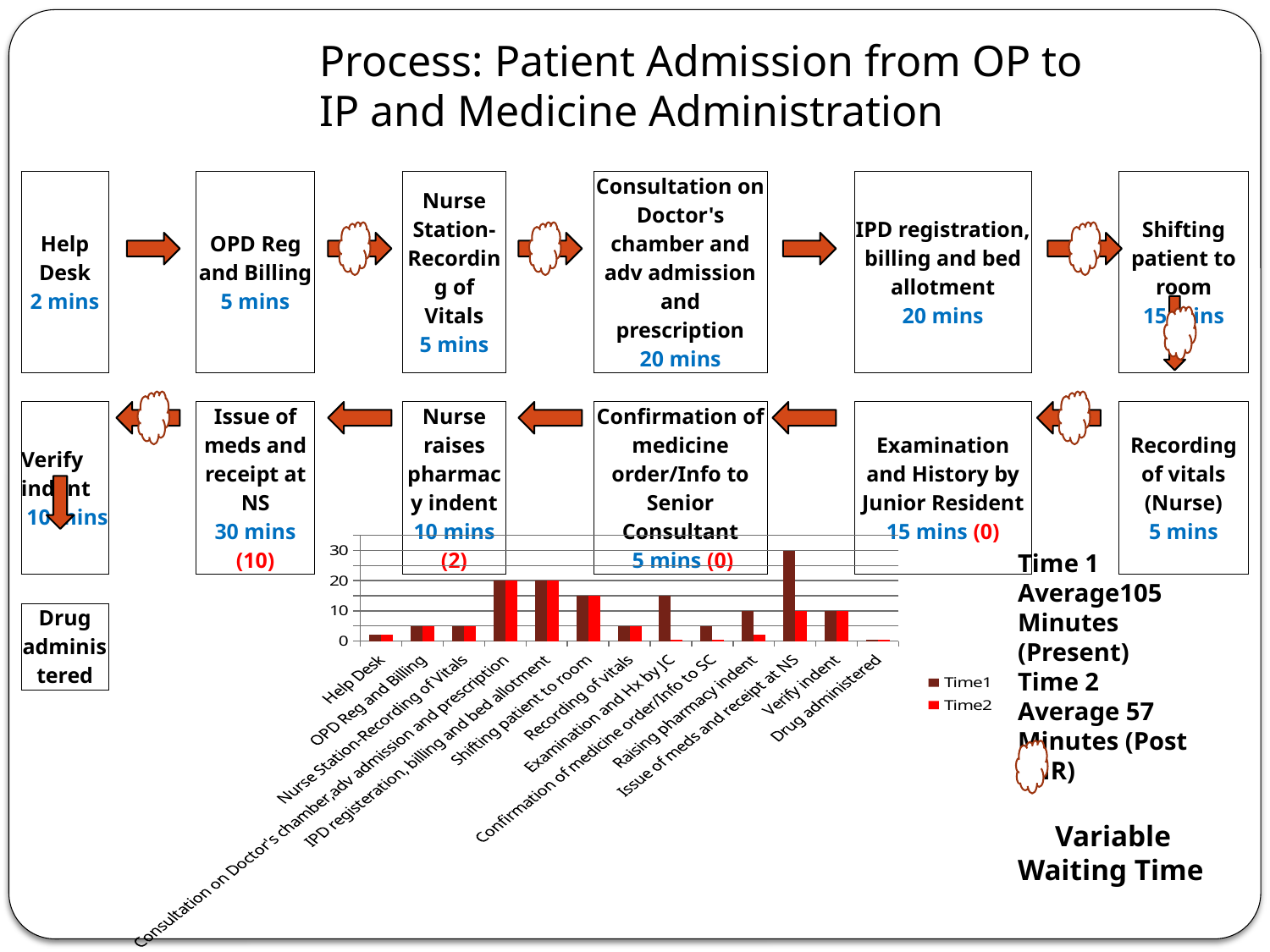
What are the two series named in the chart legend? Time1 and Time2 What is the Time1 value for Issue of meds and receipt at NS? 30 For Examination and Hx by JC, which is larger, Time1 or Time2? Time1 What is the Time1 value for IPD registeration, billing and bed allotment? 20 Is the Time1 value for Help Desk greater or less than 10? less What kind of chart is shown on the slide? bar chart How many series does the chart's legend list? 2 How many categories are plotted along the x axis of the chart? 13 Which category has the highest Time1 value in the chart? Issue of meds and receipt at NS What is the Time2 value for Issue of meds and receipt at NS? 10 Is the Time1 value for Shifting patient to room greater or less than 10? greater What is the difference between Time1 and Time2 for Issue of meds and receipt at NS? 20